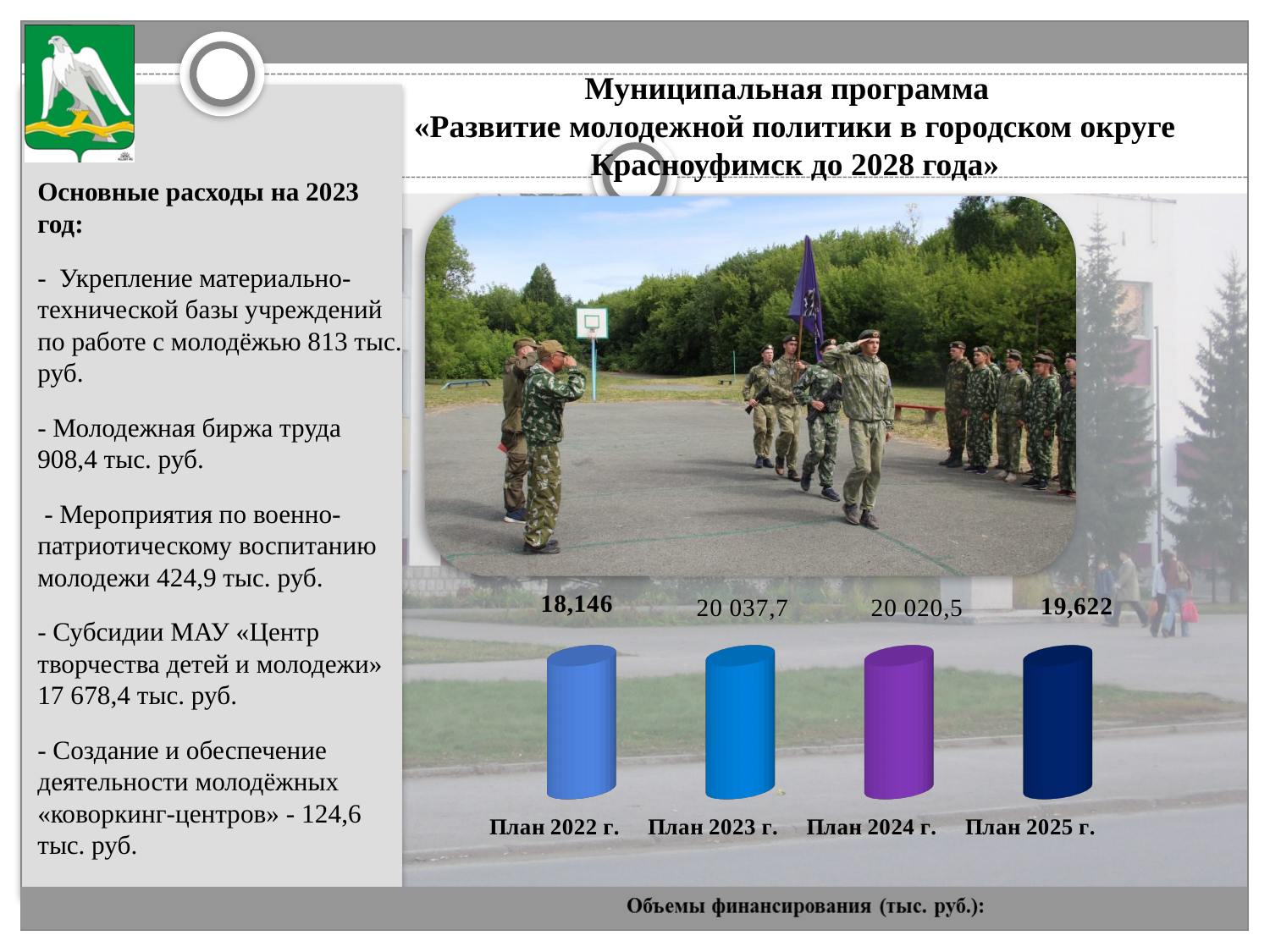
How many categories are shown in the chart? 4 Which is larger, the value for План 2023 г. or the value for План 2024 г.? План 2023 г. What is the value shown for План 2022 г.? 18,146 From План 2023 г. to План 2025 г., do the values rise or fall? fall What kind of chart is shown on the slide? bar chart What is the value shown for План 2025 г.? 19,622 What is the difference between the values for План 2023 г. and План 2024 г.? 17,2 What is the value shown for План 2024 г.? 20 020,5 Which category has the lowest value? План 2022 г. What is the value shown for План 2023 г.? 20 037,7 What unit is given in the caption below the chart? тыс. руб. Which category has the highest value? План 2023 г.